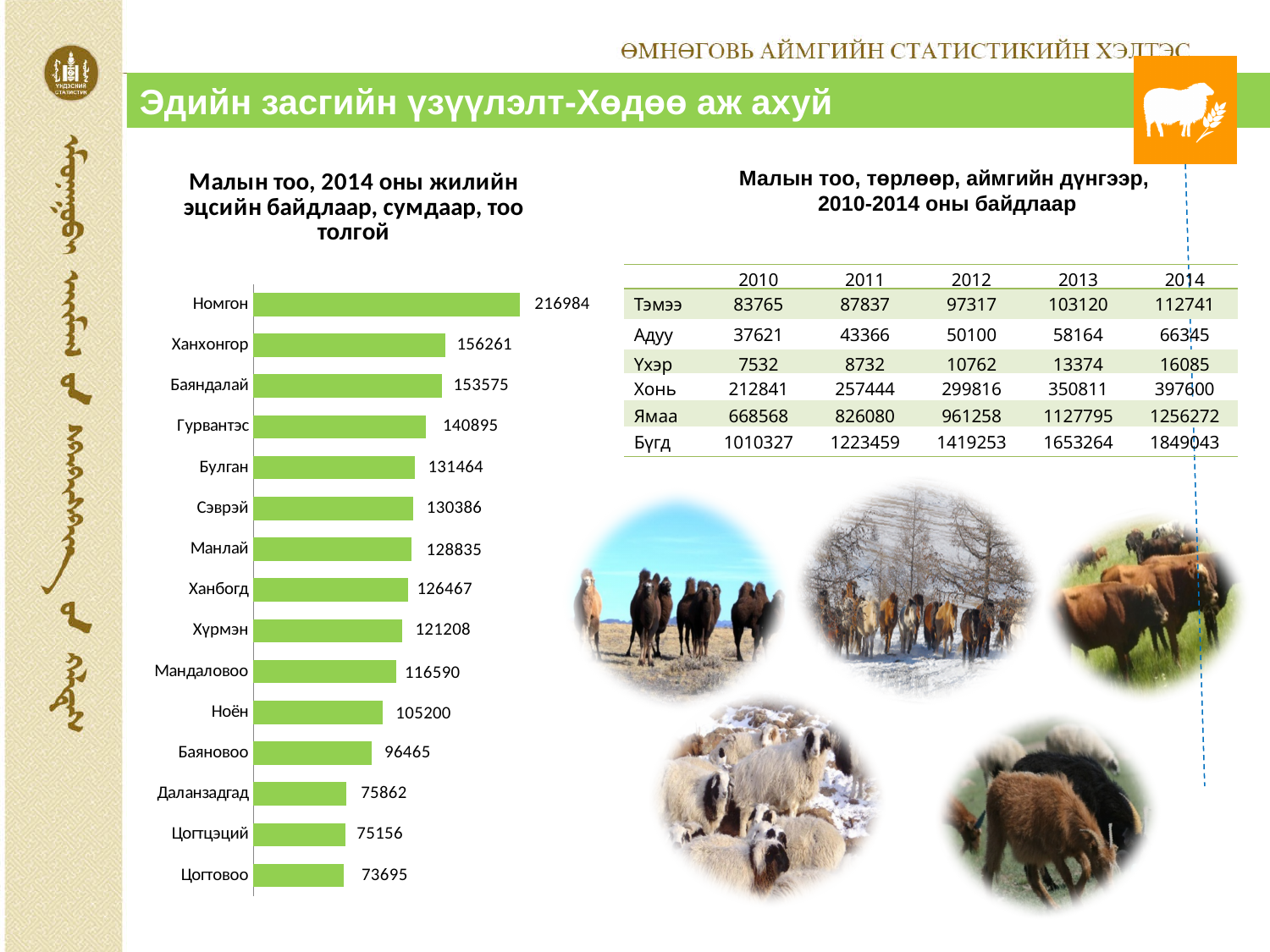
In the bar chart, what is the value for Гурвантэс? 140895 Which category has the lowest value in the bar chart? Цогтовоо In the bar chart, what is the value for Мандаловоо? 116590 Which category has the highest value in the bar chart? Номгон What is the title of the bar chart? Малын тоо, 2014 оны жилийн эцсийн байдлаар, сумдаар, тоо толгой What kind of chart is shown on the left of the slide? bar chart In the bar chart, what is the difference between the values for Номгон and Ханхонгор? 60723 In the bar chart, what is the value for Даланзадгад? 75862 In the bar chart, what is the value for Номгон? 216984 How many categories are shown in the bar chart? 15 In the bar chart, do the values increase or decrease going from the top bar to the bottom bar? decrease In the bar chart, which is larger: the value for Ханхонгор or the value for Баяндалай? Ханхонгор